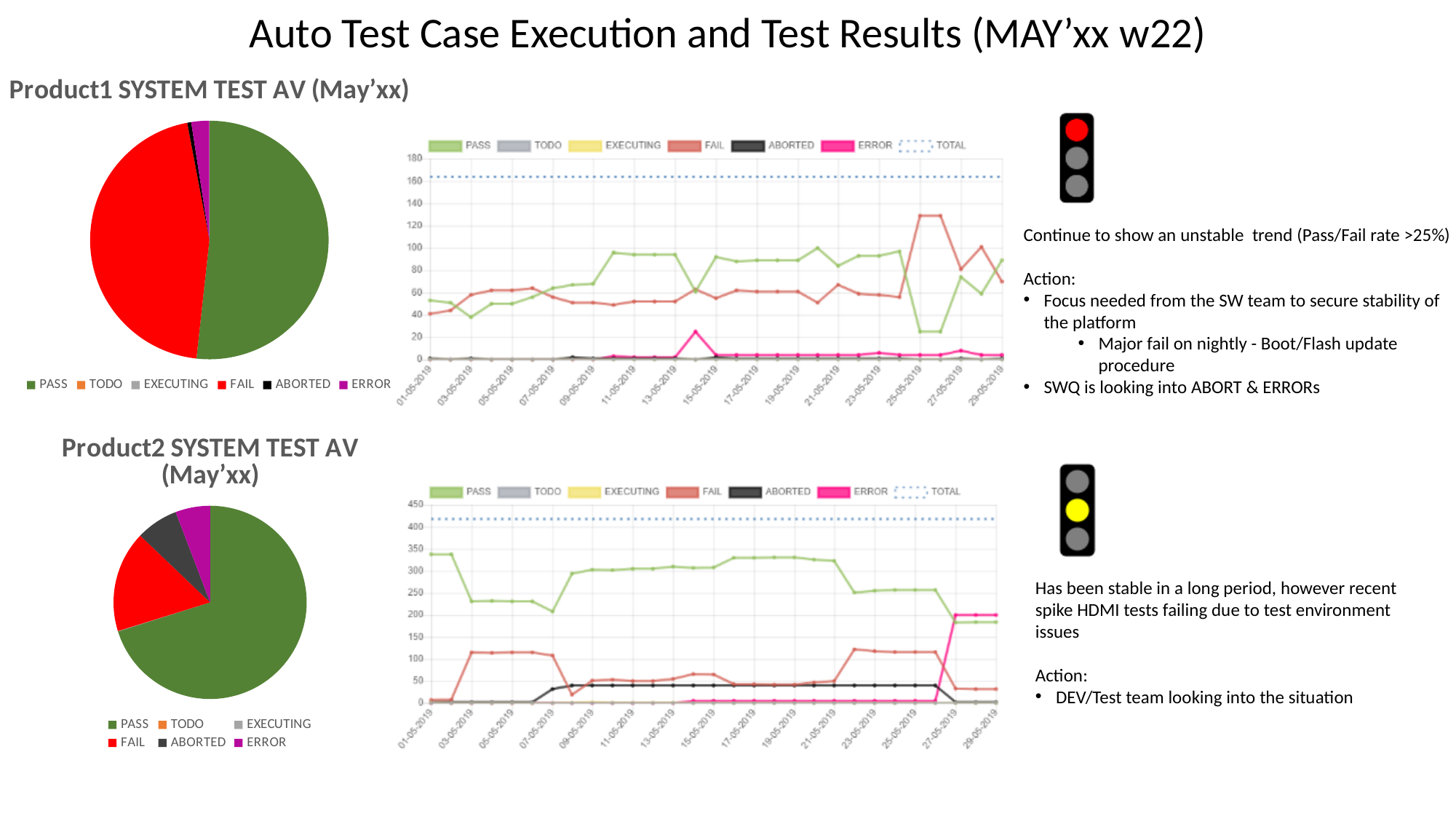
In the Product2 SYSTEM TEST AV (May'xx) pie chart, which slice is larger, FAIL or ABORTED? FAIL In the Product1 SYSTEM TEST AV (May'xx) pie chart, which category has the largest slice? PASS In the Product1 SYSTEM TEST AV (May'xx) pie chart, which slice is larger, PASS or FAIL? PASS How many series does the legend of the Product1 pie chart list? 6 How many series does the legend of the upper line chart list? 7 In the Product2 SYSTEM TEST AV (May'xx) pie chart, which category has the largest slice? PASS What kind of chart is the chart to the right of the Product2 pie chart? line chart In the upper line chart (Product1), is the FAIL value on 25-05-2019 greater or less than 120? greater In the lower line chart (Product2), is the dotted TOTAL line greater or less than 400? greater In the Product1 pie chart legend, what colour represents PASS? green In the lower line chart (Product2), is the PASS value on 01-05-2019 greater or less than 300? greater What kind of chart is the Product1 SYSTEM TEST AV (May'xx) chart on the left? pie chart